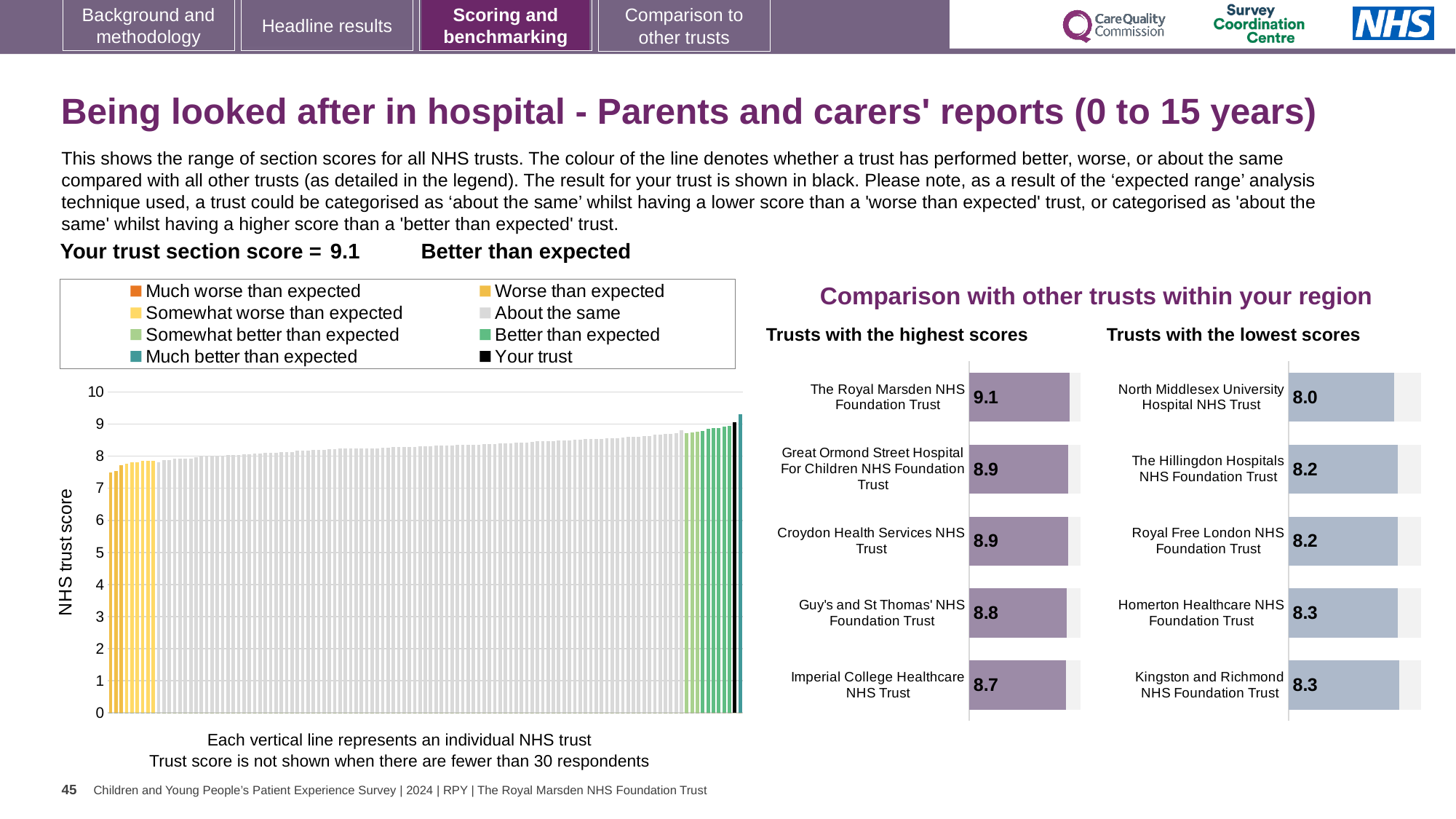
In the 'Trusts with the highest scores' chart, which trust has the highest score? The Royal Marsden NHS Foundation Trust In the 'Trusts with the lowest scores' chart, what is the difference between the scores of Kingston and Richmond NHS Foundation Trust and North Middlesex University Hospital NHS Trust? 0.3 How many trusts are listed in the 'Trusts with the highest scores' chart? 5 In the 'Trusts with the lowest scores' chart, what is the score for Homerton Healthcare NHS Foundation Trust? 8.3 How many entries does the legend of the NHS trust score chart on the left list? 8 In the NHS trust score chart on the left, do the values rise or fall from left to right? Rise In the NHS trust score chart on the left, is the value of the black 'Your trust' bar greater or less than 8? greater In the 'Trusts with the lowest scores' chart, which trust has the lowest score? North Middlesex University Hospital NHS Trust In the 'Trusts with the highest scores' chart, what is the difference between the scores of The Royal Marsden NHS Foundation Trust and Imperial College Healthcare NHS Trust? 0.4 In the 'Trusts with the highest scores' chart, what is the score for Imperial College Healthcare NHS Trust? 8.7 What kind of chart is the NHS trust score chart on the left of the slide? Bar chart In the 'Trusts with the highest scores' chart, which has the higher score: Guy's and St Thomas' NHS Foundation Trust or Croydon Health Services NHS Trust? Croydon Health Services NHS Trust